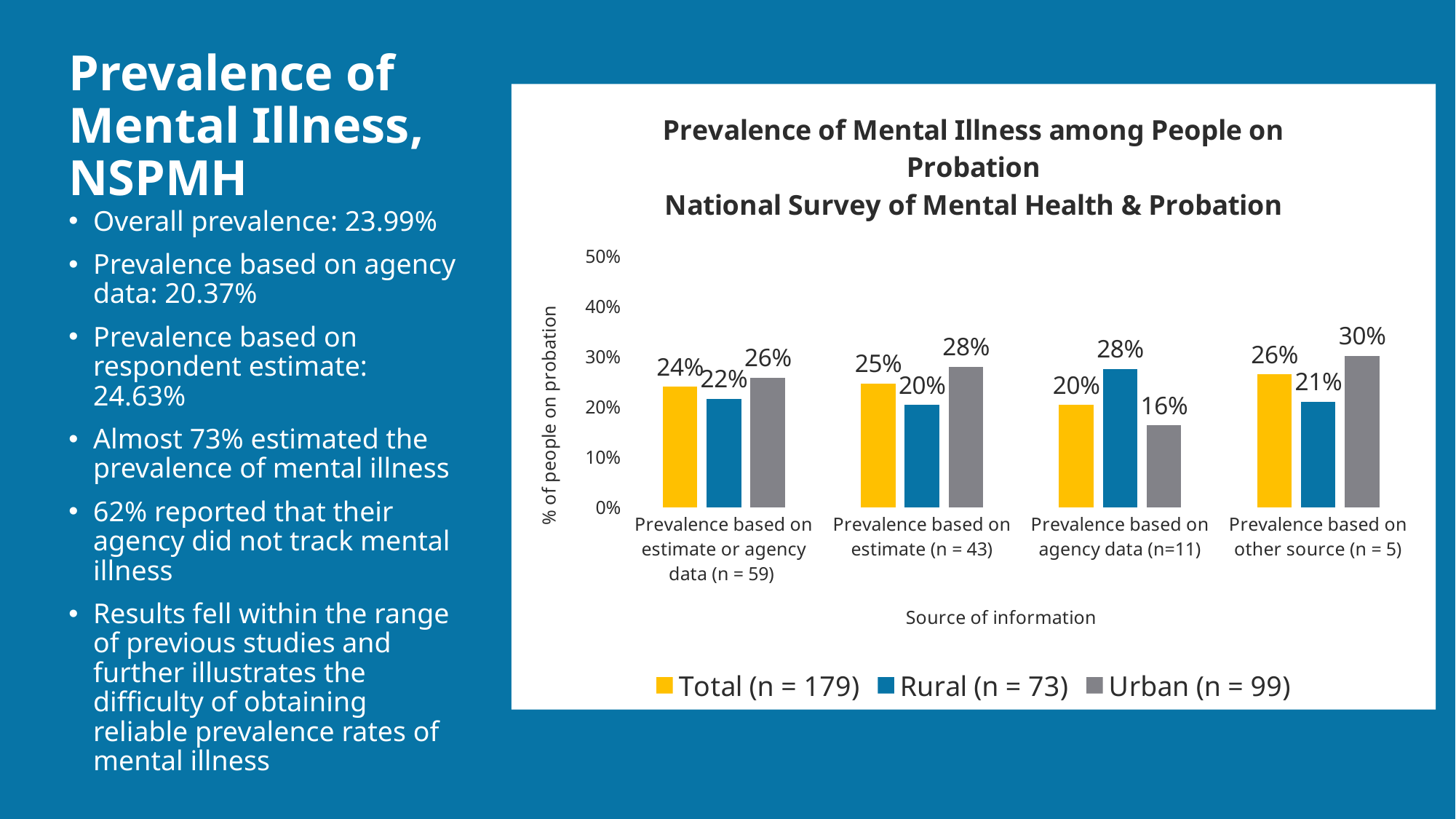
For 'Prevalence based on estimate (n = 43)', which is larger: the Rural value or the Urban value? Urban What is the Rural (n = 73) value for 'Prevalence based on agency data (n=11)'? 28% What kind of chart is shown on the slide? bar chart How many categories are shown on the x axis? 4 Which category has the lowest Urban (n = 99) value? Prevalence based on agency data (n=11) What is the Total (n = 179) value for 'Prevalence based on estimate (n = 43)'? 25% What is the label of the y axis? % of people on probation What is the Urban (n = 99) value for 'Prevalence based on other source (n = 5)'? 30% What is the difference between the Rural and Urban values for 'Prevalence based on agency data (n=11)'? 12% Is the Urban value for 'Prevalence based on agency data (n=11)' greater or less than 20%? less How many series does the legend list? 3 Which category has the highest Urban (n = 99) value? Prevalence based on other source (n = 5)